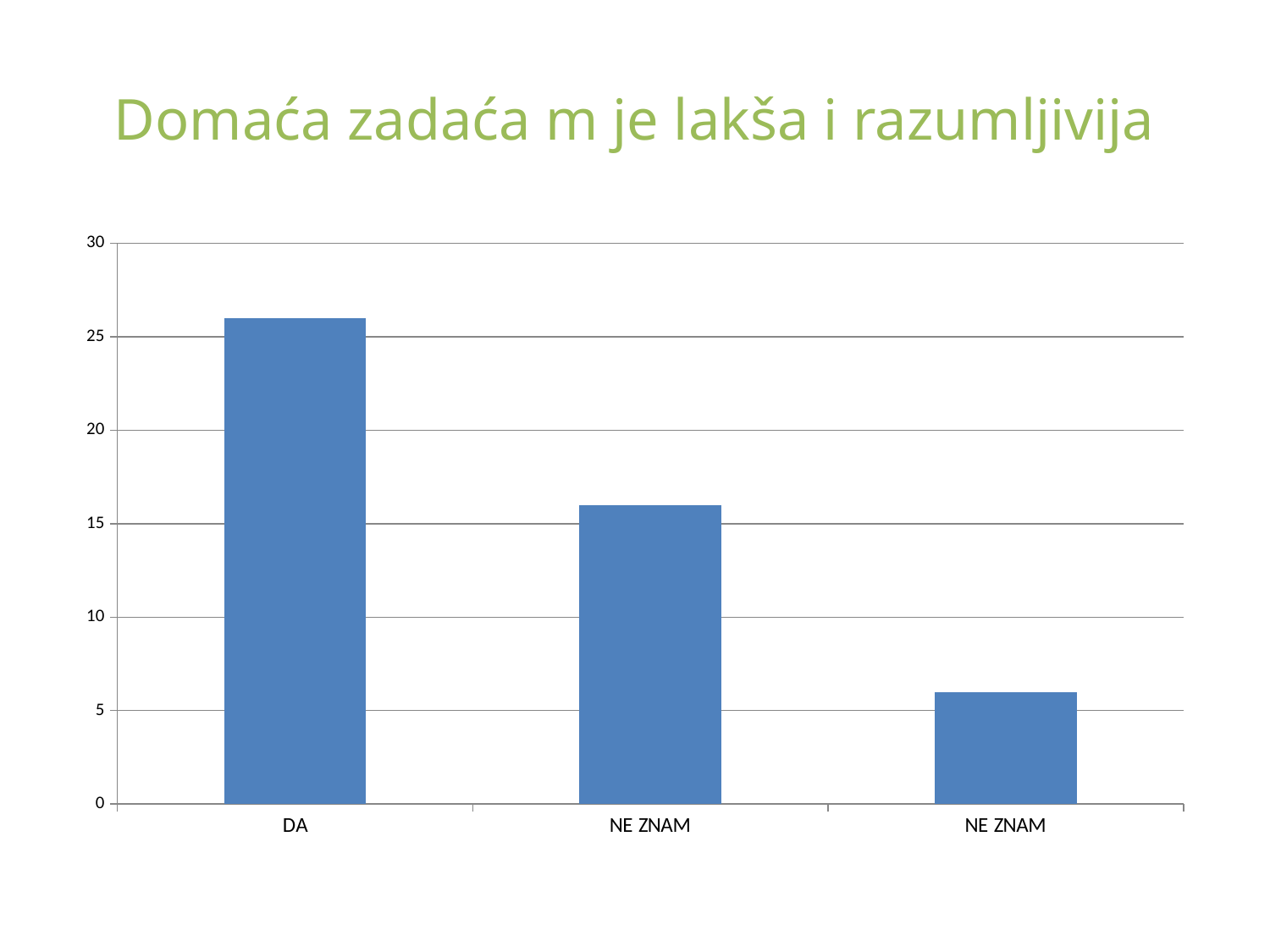
Is the value for DA greater or less than 25? greater Which category has the highest bar? DA Is the value of the middle bar (NE ZNAM) greater or less than 20? less Which is larger, the value for DA or the value of the middle NE ZNAM bar? DA Is the value of the rightmost bar (NE ZNAM) greater or less than 10? less What kind of chart is shown on the slide? bar chart What is the title of the slide? Domaća zadaća m je lakša i razumljivija How many bars does the chart have? 3 Do the bar values rise or fall from left to right across the x axis? fall